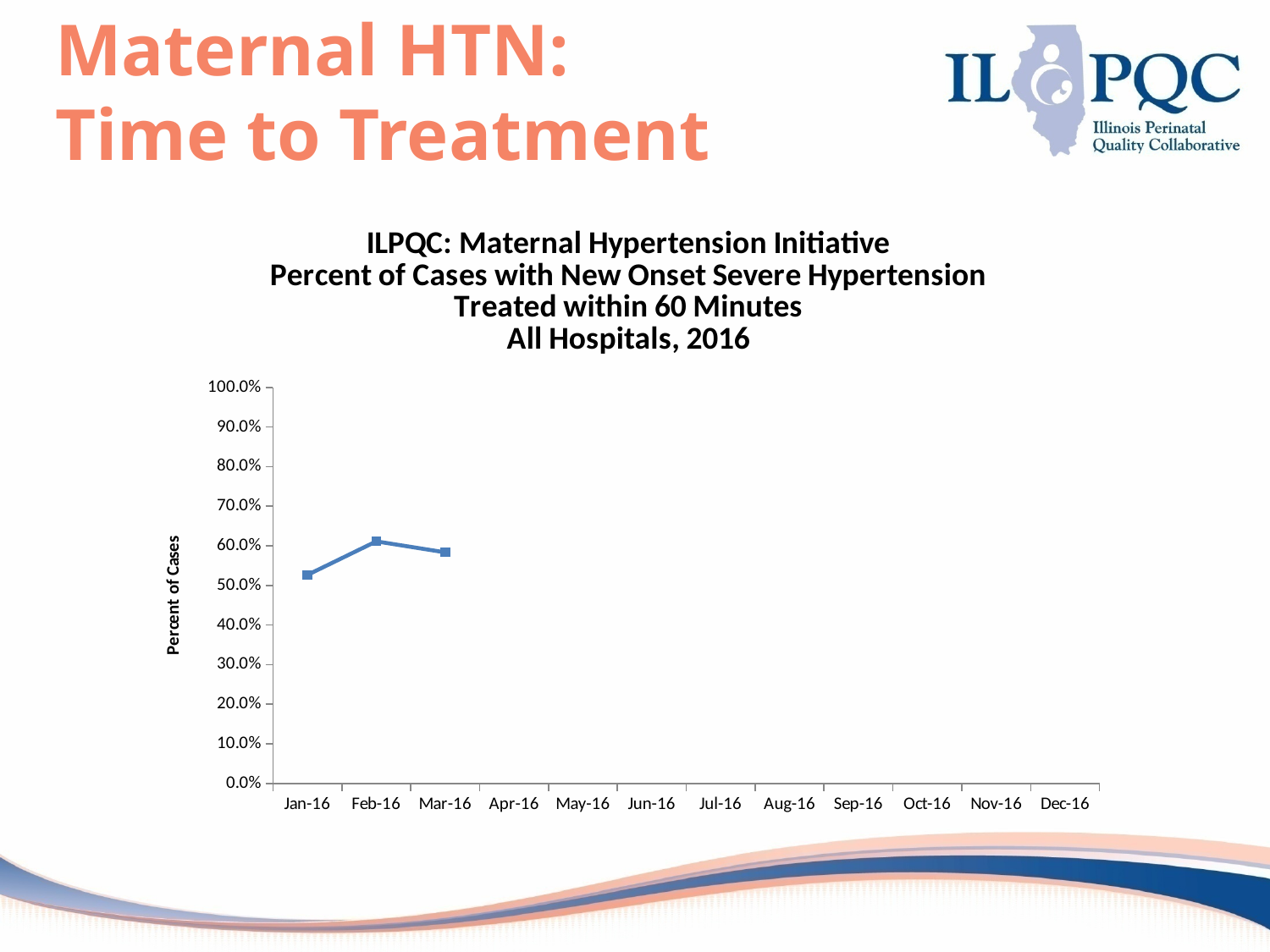
What is the label on the y axis? Percent of Cases How many data points are plotted on the line? 3 Which month has the highest plotted value? Feb-16 Is the value for Feb-16 greater or less than 70.0%? less Which is larger, the value for Feb-16 or the value for Mar-16? Feb-16 How many months are labeled along the x axis? 12 What kind of chart is shown on the slide? line chart Is the value for Jan-16 greater or less than 50.0%? greater From Jan-16 to Feb-16, does the plotted value rise or fall? rise Which month has the lowest plotted value? Jan-16 What is the last line of the chart title? All Hospitals, 2016 Is the value for Mar-16 greater or less than 50.0%? greater